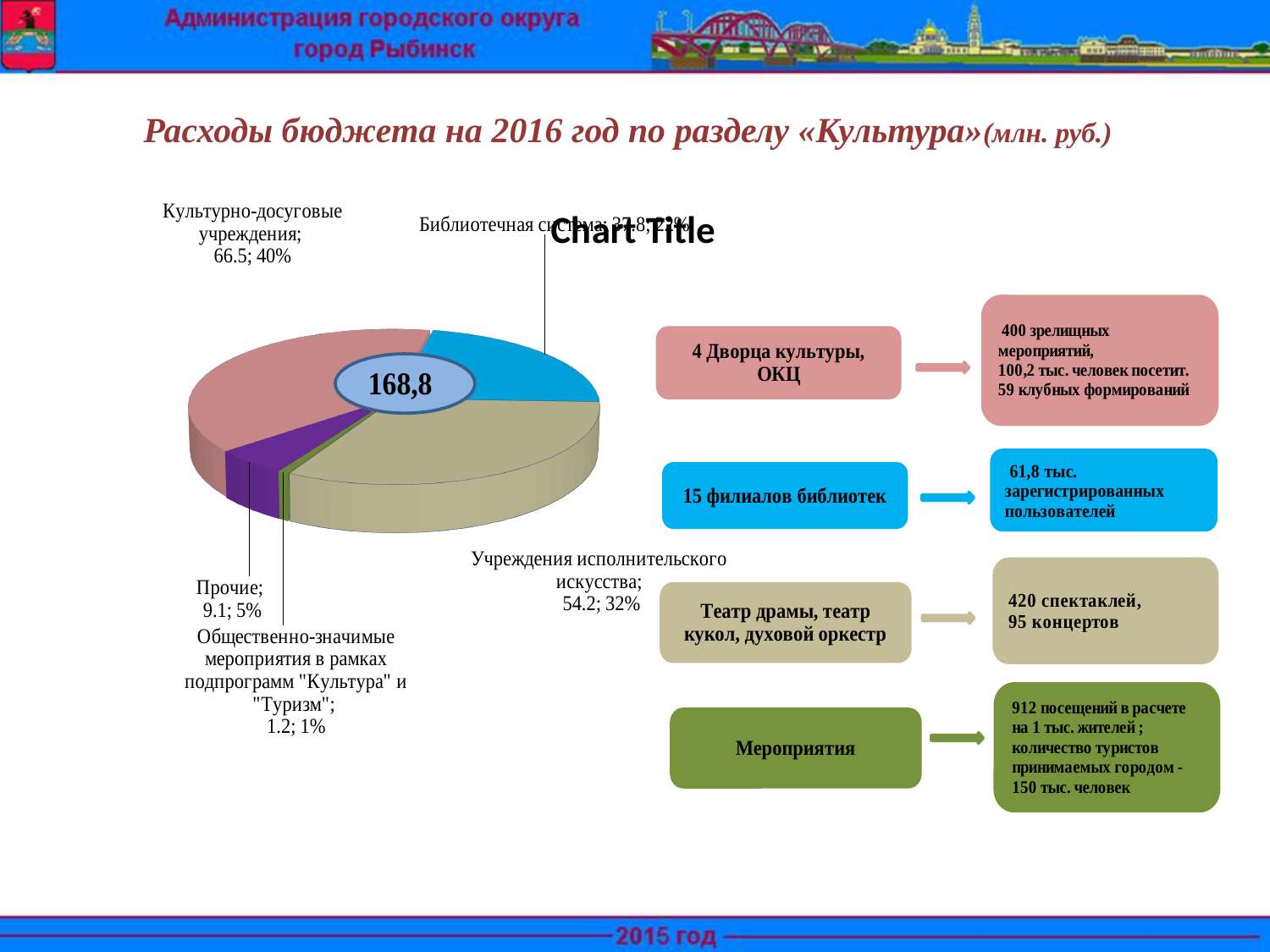
What is the difference between the values for Культурно-досуговые учреждения and Учреждения исполнительского искусства? 12.3 What is the value for Учреждения исполнительского искусства in the pie chart? 54.2 What share of the pie does Прочие represent? 5% What total value is shown in the centre of the pie chart? 168,8 What is the value for Прочие in the pie chart? 9.1 What is the value for Общественно-значимые мероприятия в рамках подпрограмм "Культура" и "Туризм"? 1.2 What is the value for Культурно-досуговые учреждения in the pie chart? 66.5 What share of the pie does Культурно-досуговые учреждения represent? 40% Which category has the largest slice of the pie chart? Культурно-досуговые учреждения Which category has the smallest slice of the pie chart? Общественно-значимые мероприятия в рамках подпрограмм "Культура" и "Туризм" What share of the pie does Учреждения исполнительского искусства represent? 32% What type of chart is shown on the slide? pie chart